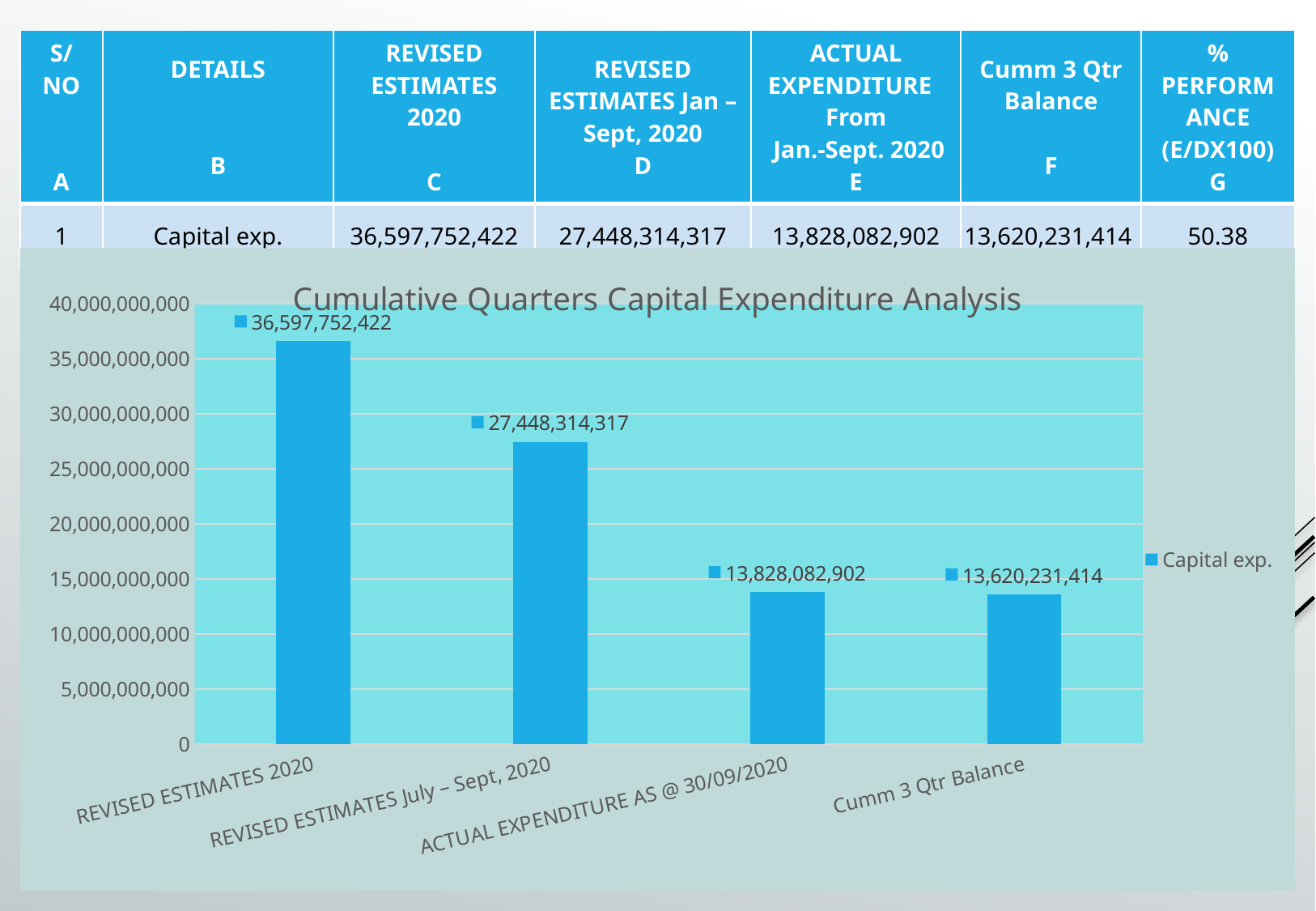
How many series does the legend list? 1 How many categories are shown on the x axis? 4 What is the value for REVISED ESTIMATES 2020? 36,597,752,422 Is the value for ACTUAL EXPENDITURE AS @ 30/09/2020 greater or less than 15,000,000,000? less What is the value for ACTUAL EXPENDITURE AS @ 30/09/2020? 13,828,082,902 Which category has the lowest value? Cumm 3 Qtr Balance Which category has the highest value? REVISED ESTIMATES 2020 What type of chart is shown on the slide? Bar chart What is the value for REVISED ESTIMATES July – Sept, 2020? 27,448,314,317 What is the difference between REVISED ESTIMATES 2020 and REVISED ESTIMATES July – Sept, 2020? 9,149,438,105 What is the title of the chart? Cumulative Quarters Capital Expenditure Analysis What is the value for Cumm 3 Qtr Balance? 13,620,231,414